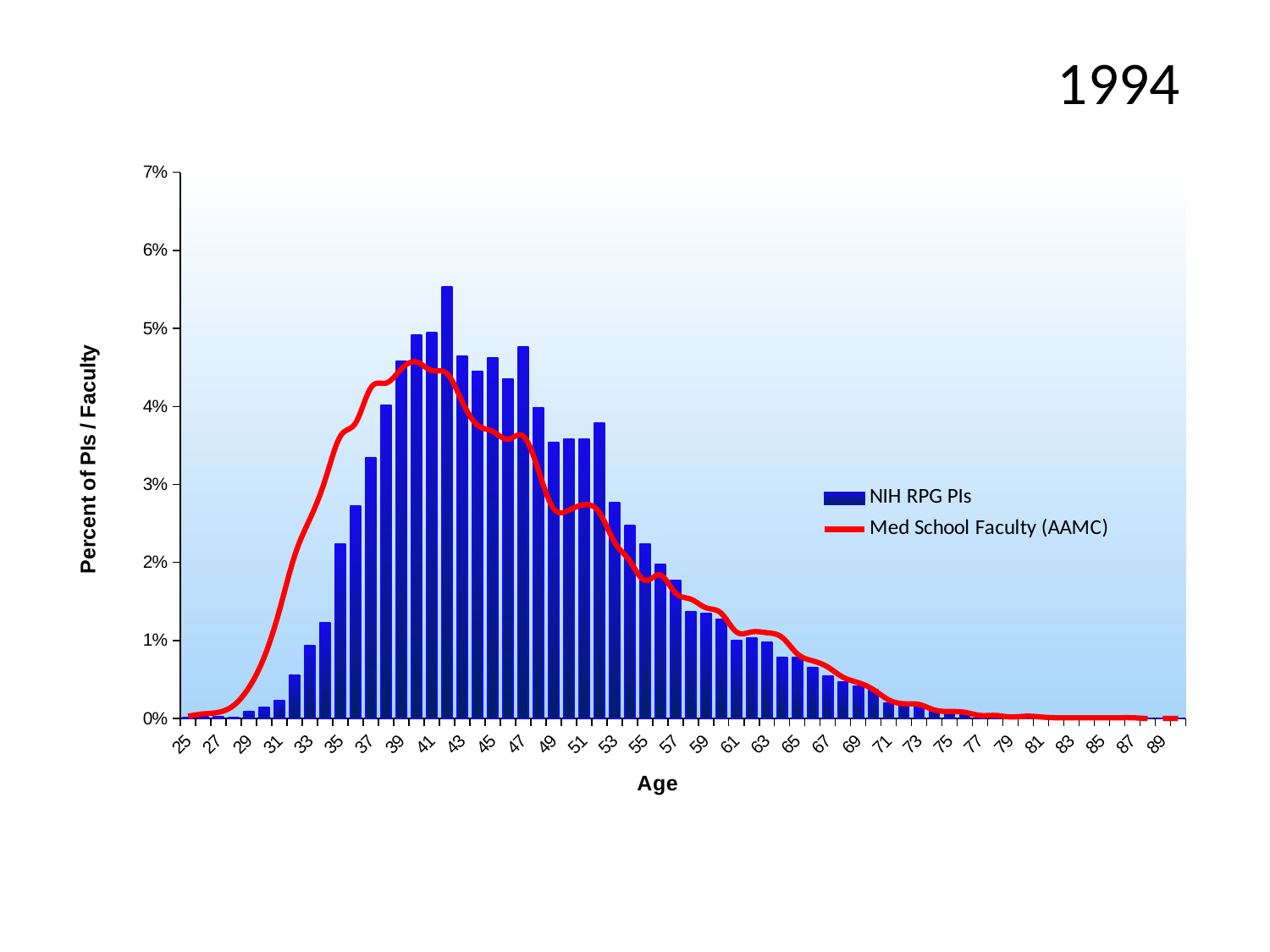
Is the NIH RPG PIs value at age 31 greater or less than 1%? less At age 35, which is larger: the NIH RPG PIs bar or the Med School Faculty (AAMC) line? Med School Faculty (AAMC) What is the title shown at the top of the slide? 1994 Is the Med School Faculty (AAMC) value at age 51 greater or less than 3%? less At which age is the NIH RPG PIs bar the highest? 42 Do the NIH RPG PIs values rise or fall from age 43 to age 59? fall What are the two series named in the legend? NIH RPG PIs and Med School Faculty (AAMC) Is the Med School Faculty (AAMC) value at age 39 greater or less than 4%? greater What kind of chart is shown on the slide? Bar chart with a line overlay How many series does the legend list? 2